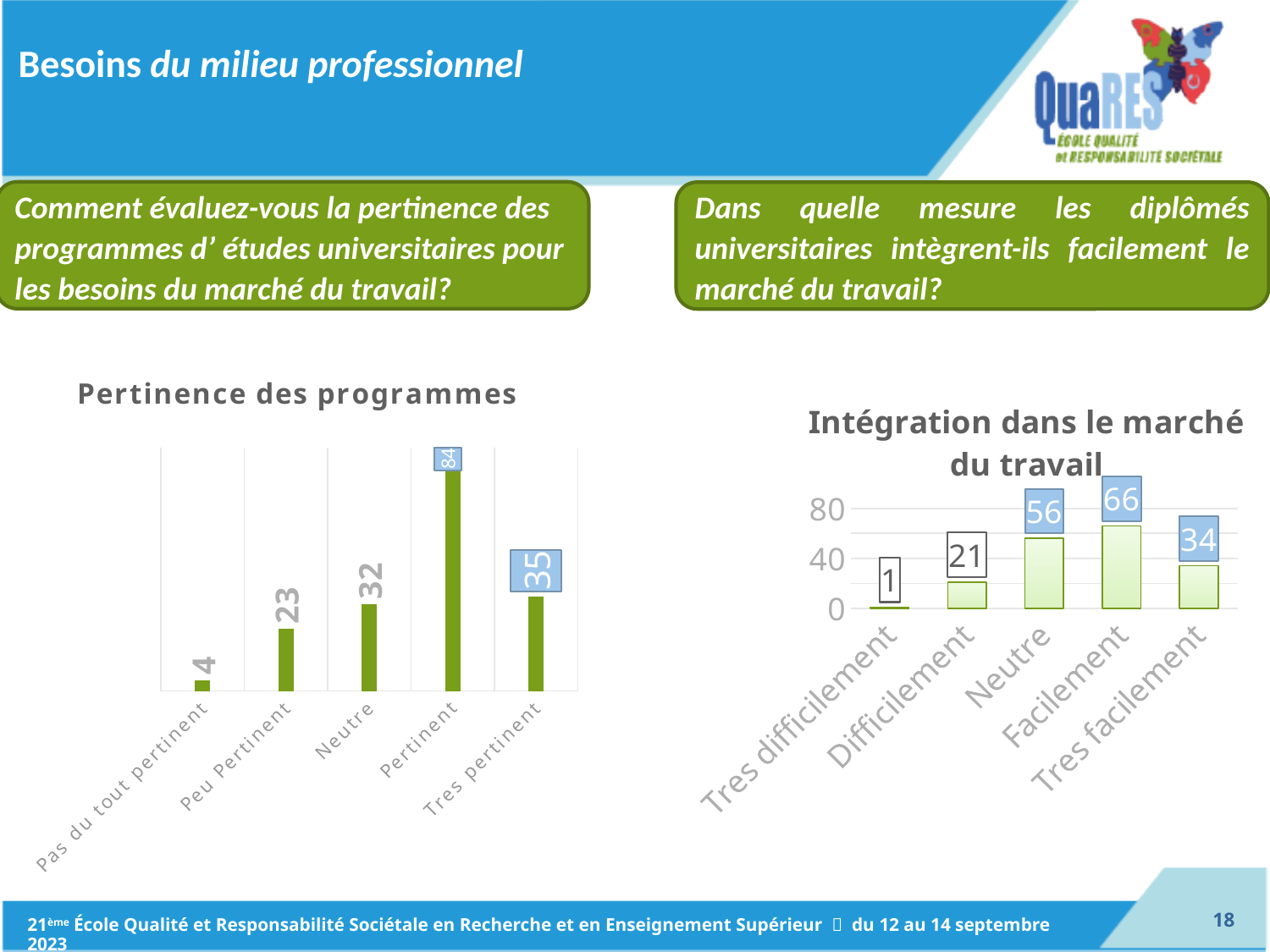
In the 'Pertinence des programmes' chart, what is the value for Pertinent? 84 In the 'Intégration dans le marché du travail' chart, which category has the highest value? Facilement In the 'Pertinence des programmes' chart, what is the value for Pas du tout pertinent? 4 In the 'Pertinence des programmes' chart, what is the difference between Pertinent and Tres pertinent? 49 In the 'Intégration dans le marché du travail' chart, what is the difference between Neutre and Tres facilement? 22 How many categories are shown in the 'Pertinence des programmes' chart? 5 In the 'Pertinence des programmes' chart, which is larger: Peu Pertinent or Neutre? Neutre What type of chart is the 'Intégration dans le marché du travail' chart? Bar chart In the 'Intégration dans le marché du travail' chart, what is the value for Facilement? 66 In the 'Intégration dans le marché du travail' chart, what is the value for Difficilement? 21 In the 'Pertinence des programmes' chart, which category has the lowest value? Pas du tout pertinent In the 'Intégration dans le marché du travail' chart, is the value for Neutre greater or less than 40? greater